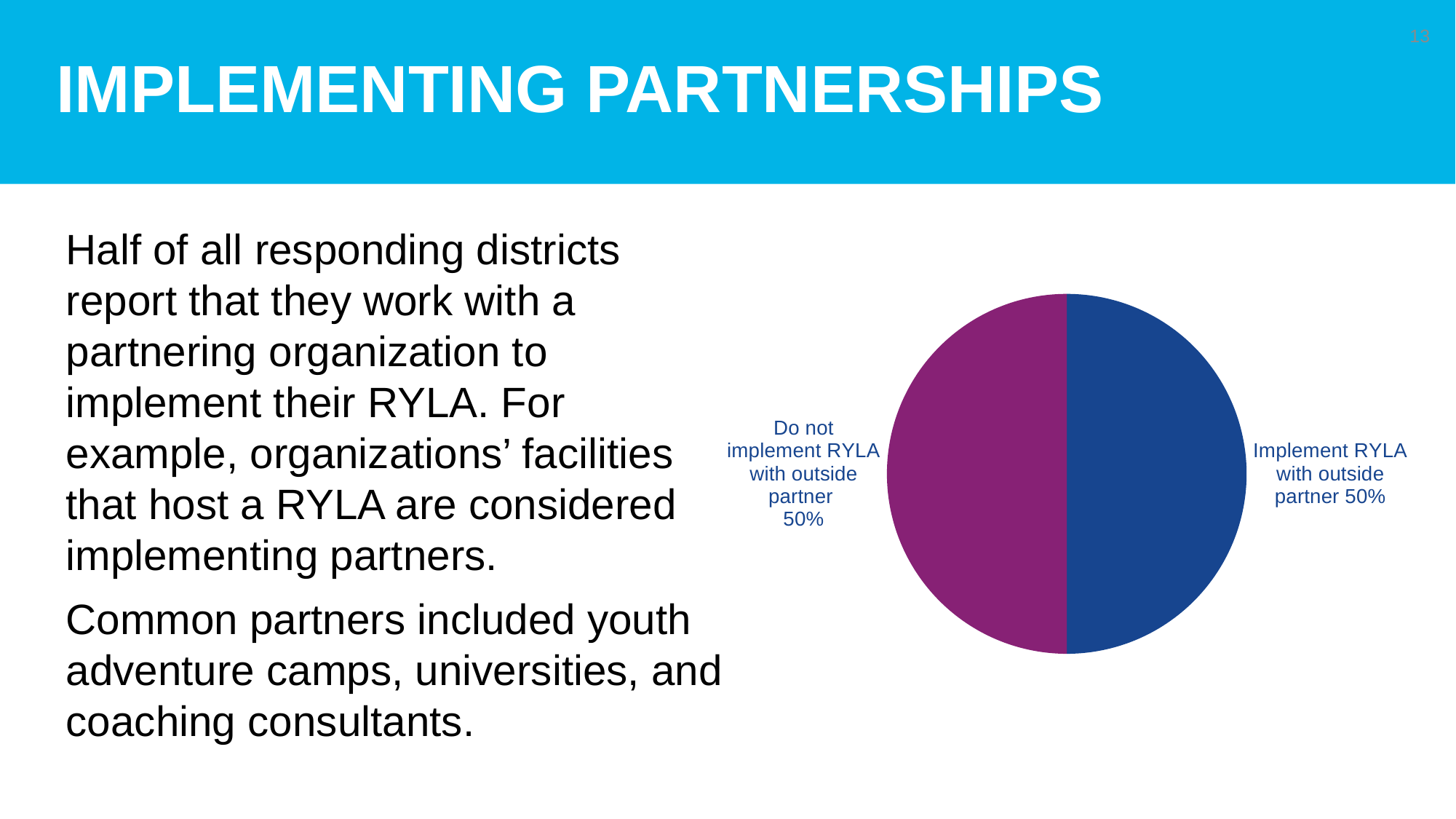
What share of the pie is labelled "Do not implement RYLA with outside partner"? 50% Which colour is the slice labelled "Implement RYLA with outside partner"? blue What kind of chart is shown on the slide? pie chart Is the share for "Do not implement RYLA with outside partner" greater or less than 75%? less Which colour is the slice labelled "Do not implement RYLA with outside partner"? purple What share of the pie is labelled "Implement RYLA with outside partner"? 50% What is the total of the two slice percentages shown on the pie chart? 100% How many slices does the pie chart have? 2 Is the share for "Implement RYLA with outside partner" greater or less than 25%? greater What is the difference between the percentage for "Implement RYLA with outside partner" and "Do not implement RYLA with outside partner"? 0%